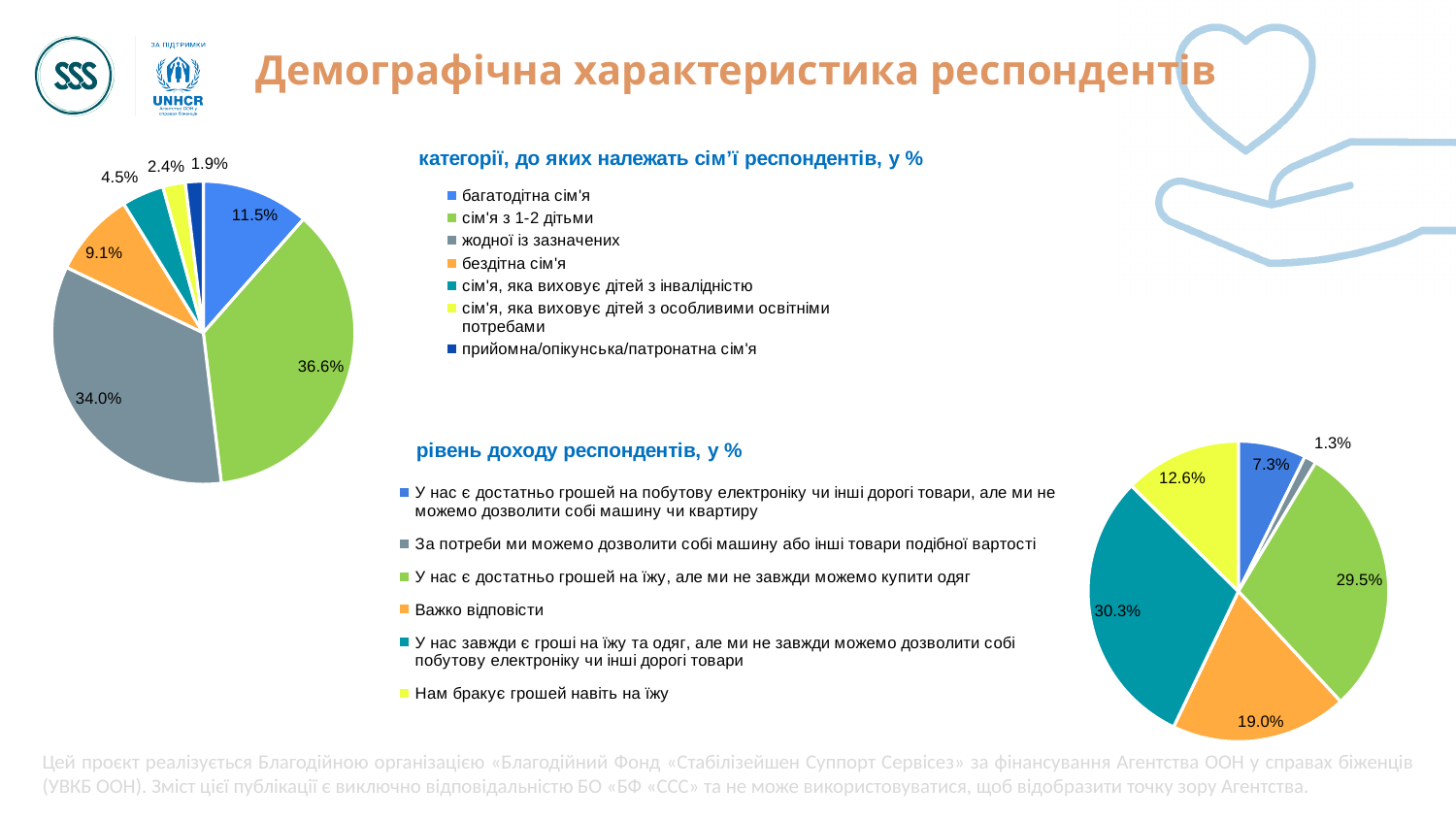
In the chart 'рівень доходу респондентів, у %', which category has the smallest share? За потреби ми можемо дозволити собі машину або інші товари подібної вартості In the chart 'рівень доходу респондентів, у %', which is larger: 'Важко відповісти' or 'Нам бракує грошей навіть на їжу'? Важко відповісти How many categories does the legend of the chart 'категорії, до яких належать сім'ї респондентів, у %' list? 7 In the chart 'категорії, до яких належать сім'ї респондентів, у %', which category has the largest share? сім'я з 1-2 дітьми In the chart 'категорії, до яких належать сім'ї респондентів, у %', what share is 'сім'я з 1-2 дітьми'? 36.6% In the chart 'рівень доходу респондентів, у %', what share is 'Важко відповісти'? 19.0% What type of chart is 'рівень доходу респондентів, у %'? Pie chart In the chart 'категорії, до яких належать сім'ї респондентів, у %', what share is 'багатодітна сім'я'? 11.5% In the chart 'категорії, до яких належать сім'ї респондентів, у %', which category has the smallest share? прийомна/опікунська/патронатна сім'я In the chart 'категорії, до яких належать сім'ї респондентів, у %', what is the difference between 'жодної із зазначених' and 'бездітна сім'я'? 24.9 percentage points How many categories does the legend of the chart 'рівень доходу респондентів, у %' list? 6 In the chart 'рівень доходу респондентів, у %', what share is 'Нам бракує грошей навіть на їжу'? 12.6%